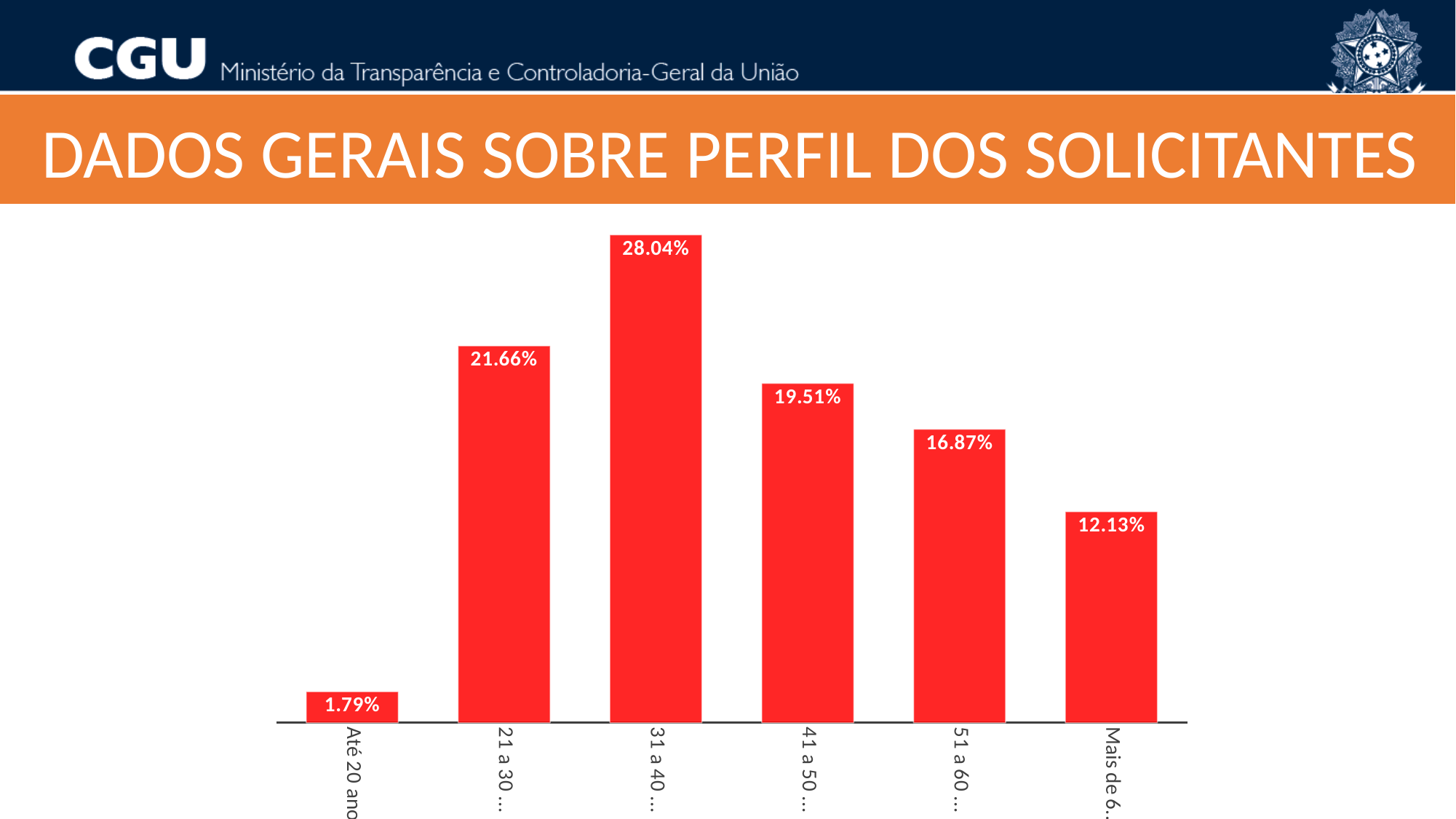
What is the value for the "21 a 30" age group? 21.66% Which age group has the lowest value? Até 20 What is the difference between the values for "31 a 40" and "21 a 30"? 6.38% Which age group has the highest value? 31 a 40 What is the value for the "51 a 60" age group? 16.87% What kind of chart is shown on the slide? bar chart Which is larger, the value for "41 a 50" or the value for "51 a 60"? 41 a 50 How many bars (age groups) does the chart show? 6 What is the value for the first bar, labelled "Até 20"? 1.79% What is the value for the "41 a 50" age group? 19.51% What is the value for the "31 a 40" age group? 28.04% What is the title shown in the orange banner above the chart? DADOS GERAIS SOBRE PERFIL DOS SOLICITANTES